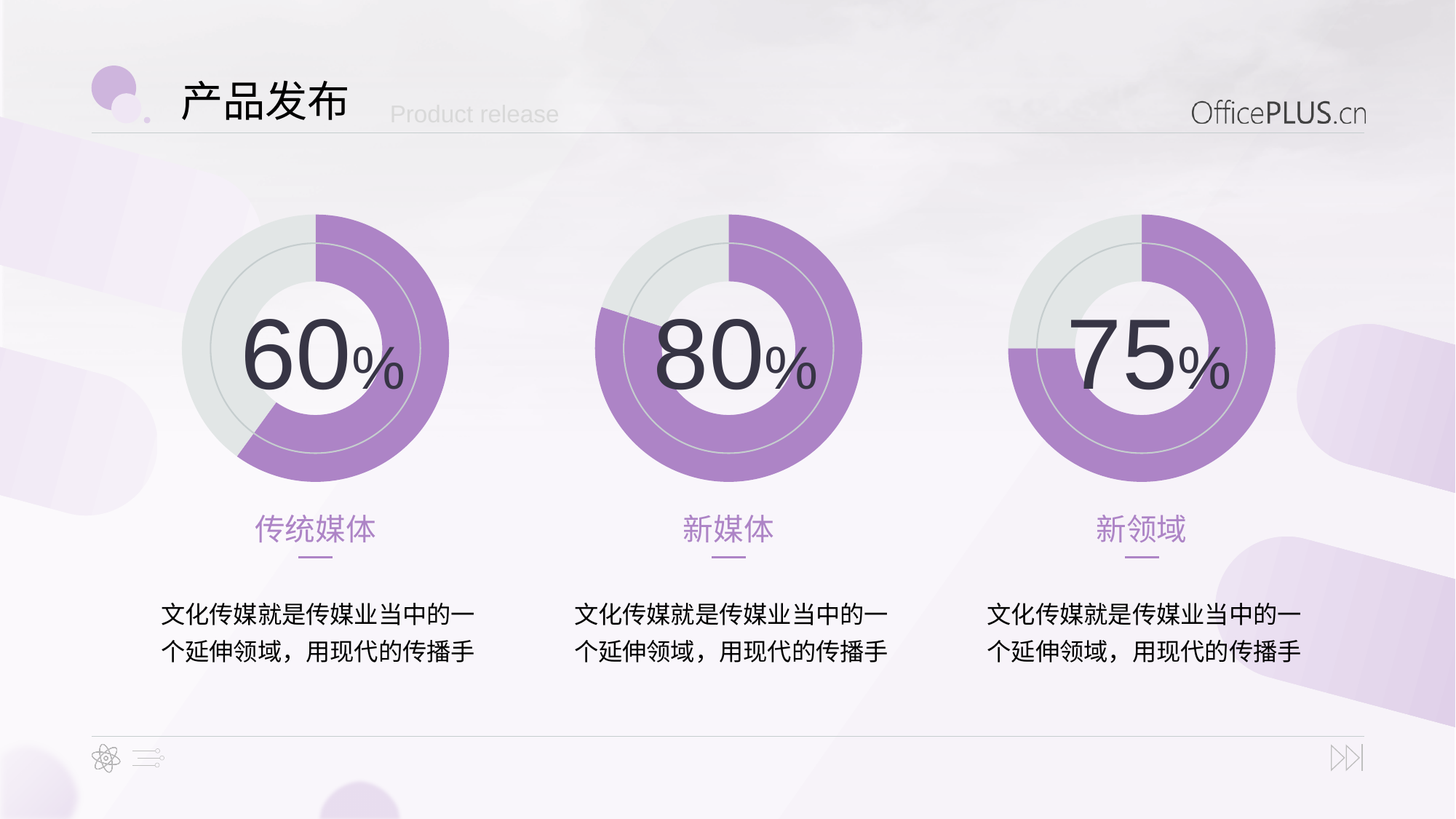
What is the difference between the percentage for 新媒体 and the percentage for 新领域? 5% What percentage is shown in the donut chart labelled 传统媒体? 60% Which of the three donut charts shows the highest percentage? 新媒体 What kind of chart is used to display the percentages on the slide? Donut chart What percentage is shown in the donut chart labelled 新领域? 75% Which of the three donut charts shows the lowest percentage? 传统媒体 How many donut charts are shown on the slide? 3 Which is larger, the percentage for 新领域 or the percentage for 传统媒体? 新领域 What percentage is shown in the donut chart labelled 新媒体? 80% What is the difference between the percentage for 新媒体 and the percentage for 传统媒体? 20% What is the title of the slide containing the three donut charts? 产品发布 What colour is the filled portion of each donut chart? Purple